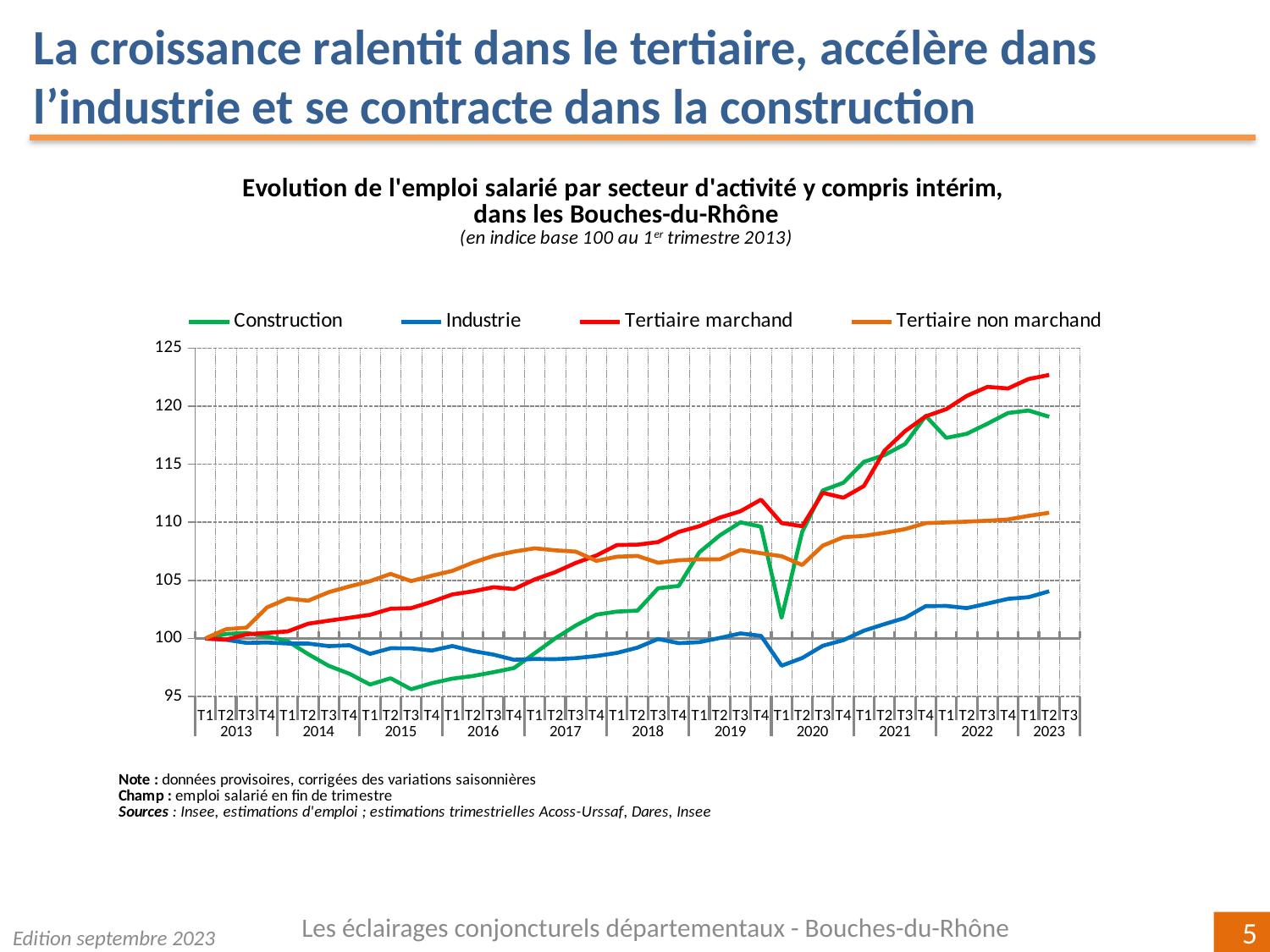
What colour is the Industrie line? blue How many series does the legend list? 4 What kind of chart is shown on the slide? line chart How many years are labelled on the x axis? 11 Is the value for Industrie at T1 2020 greater or less than 100? less Is the value for Construction at T3 2015 greater or less than 100? less